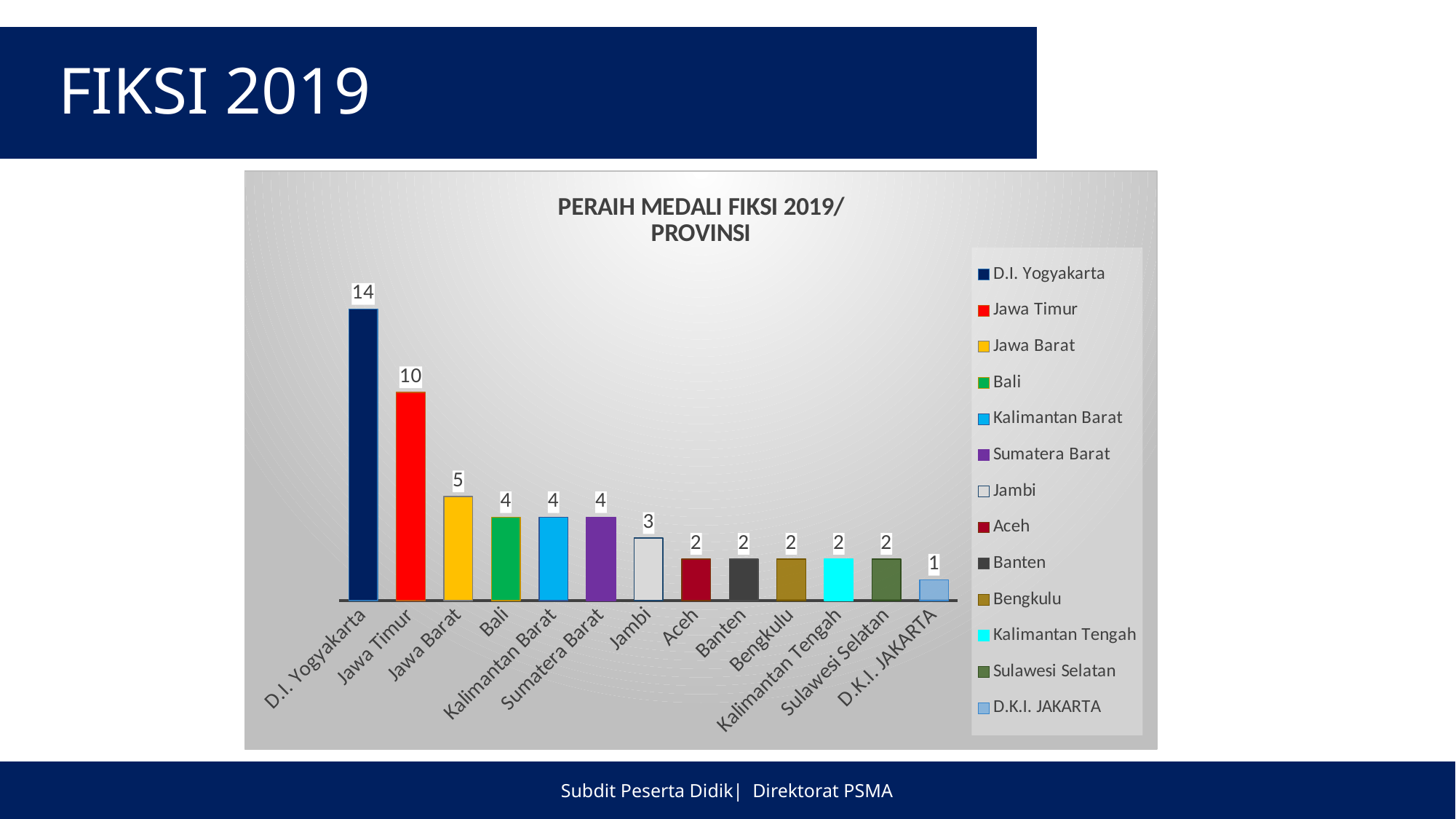
Which province has the lowest value? D.K.I. JAKARTA What is the value for Jambi? 3 What is the difference between the values for D.I. Yogyakarta and Jawa Timur? 4 What kind of chart is this? Bar chart What is the value for Jawa Timur? 10 Which province has the highest value? D.I. Yogyakarta How many provinces are shown on the x axis? 13 Which is larger, the value for Bali or the value for Aceh? Bali What is the title of the chart? PERAIH MEDALI FIKSI 2019/ PROVINSI What is the value for D.I. Yogyakarta? 14 What is the difference between the values for Jawa Barat and Jambi? 2 What is the value for D.K.I. JAKARTA? 1